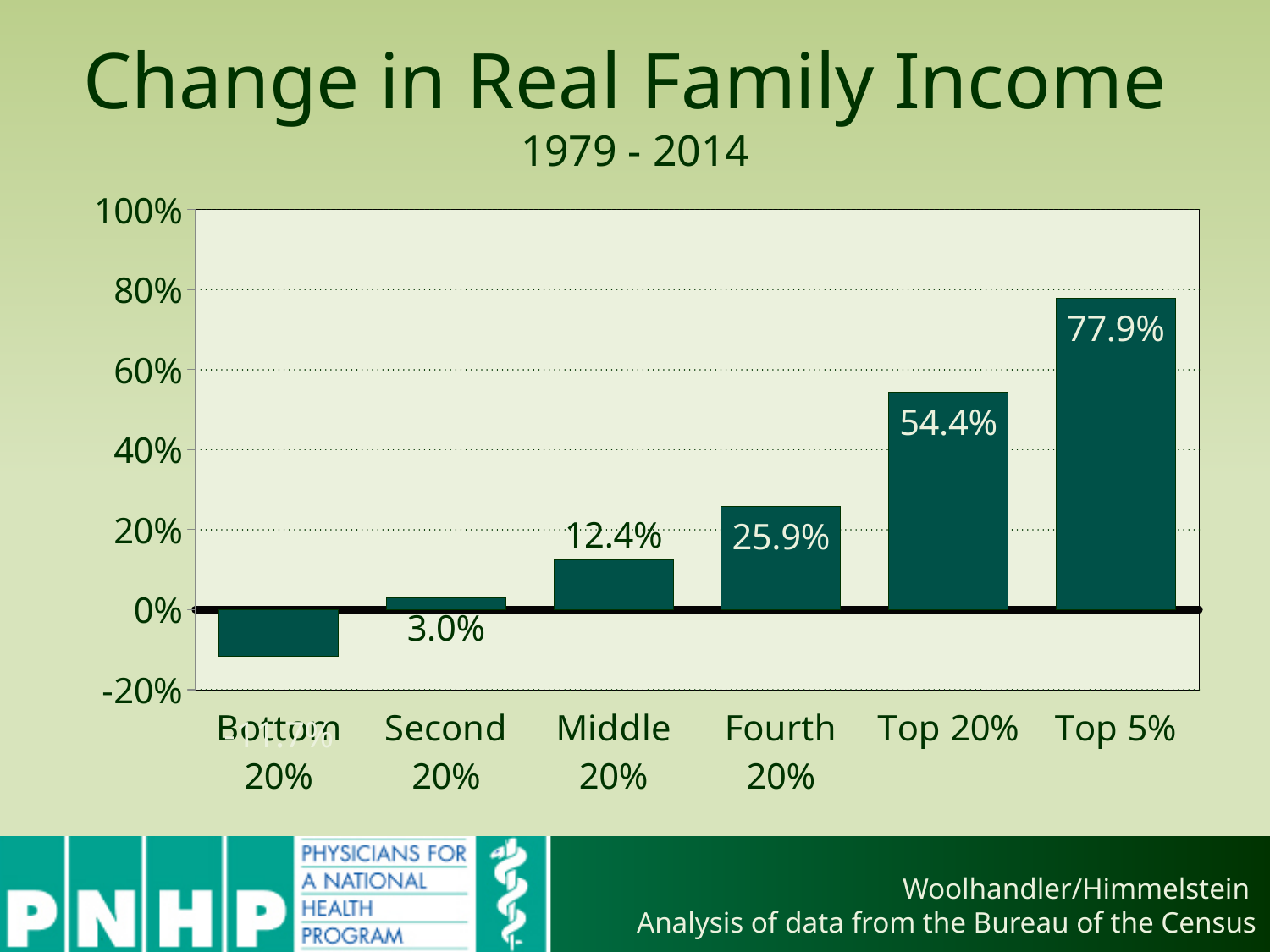
How many income groups are shown on the chart? 6 Which is larger, the change for the Fourth 20% or the Middle 20%? Fourth 20% Which income group shows the largest change in real family income? Top 5% Is the value for the Bottom 20% greater or less than 0%? less What is the difference between the change for the Top 5% and the Top 20%? 23.5% What is the difference between the change for the Fourth 20% and the Middle 20%? 13.5% Which income group shows the smallest change in real family income? Bottom 20% What is the change in real family income for the Middle 20%? 12.4% What kind of chart is shown on the slide? bar chart What is the change in real family income for the Top 5%? 77.9% What is the change in real family income for the Top 20%? 54.4% What is the change in real family income for the Second 20%? 3.0%